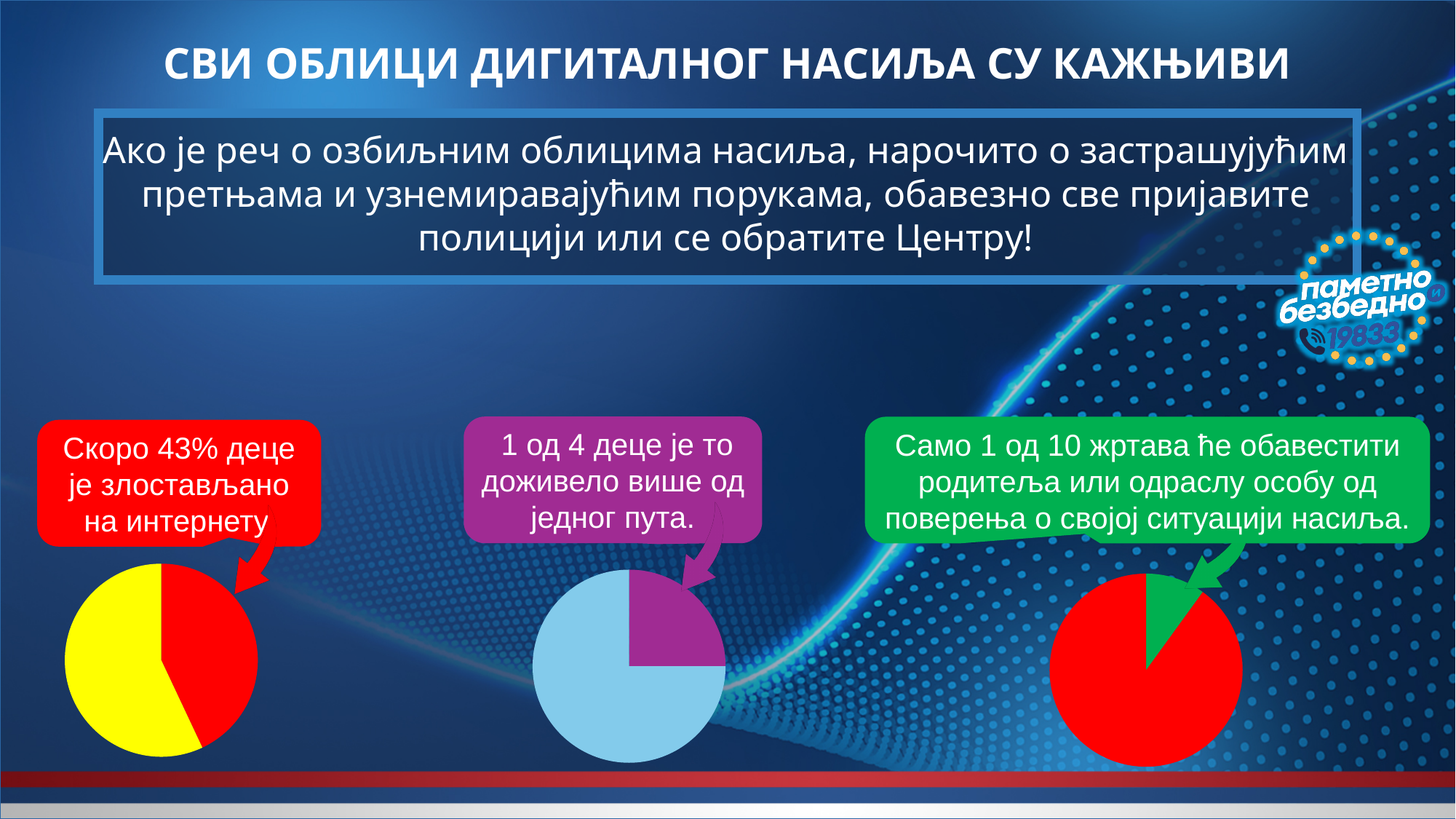
In the rightmost pie chart, which slice is smaller, the green one or the red one? green In the middle pie chart, is the purple slice more or less than half of the pie? less In the leftmost pie chart, which slice is larger, the red one or the yellow one? red What colour is the larger slice of the rightmost pie chart? red According to the callout above the middle pie chart, what share of children does the purple slice represent? 1 од 4 How many pie charts are shown on the slide? 3 What kind of chart is the leftmost chart on the slide? pie chart How many slices does the leftmost pie chart have? 2 How many slices does the middle pie chart have? 2 According to the callout above the rightmost pie chart, what share of victims does the green slice represent? 1 од 10